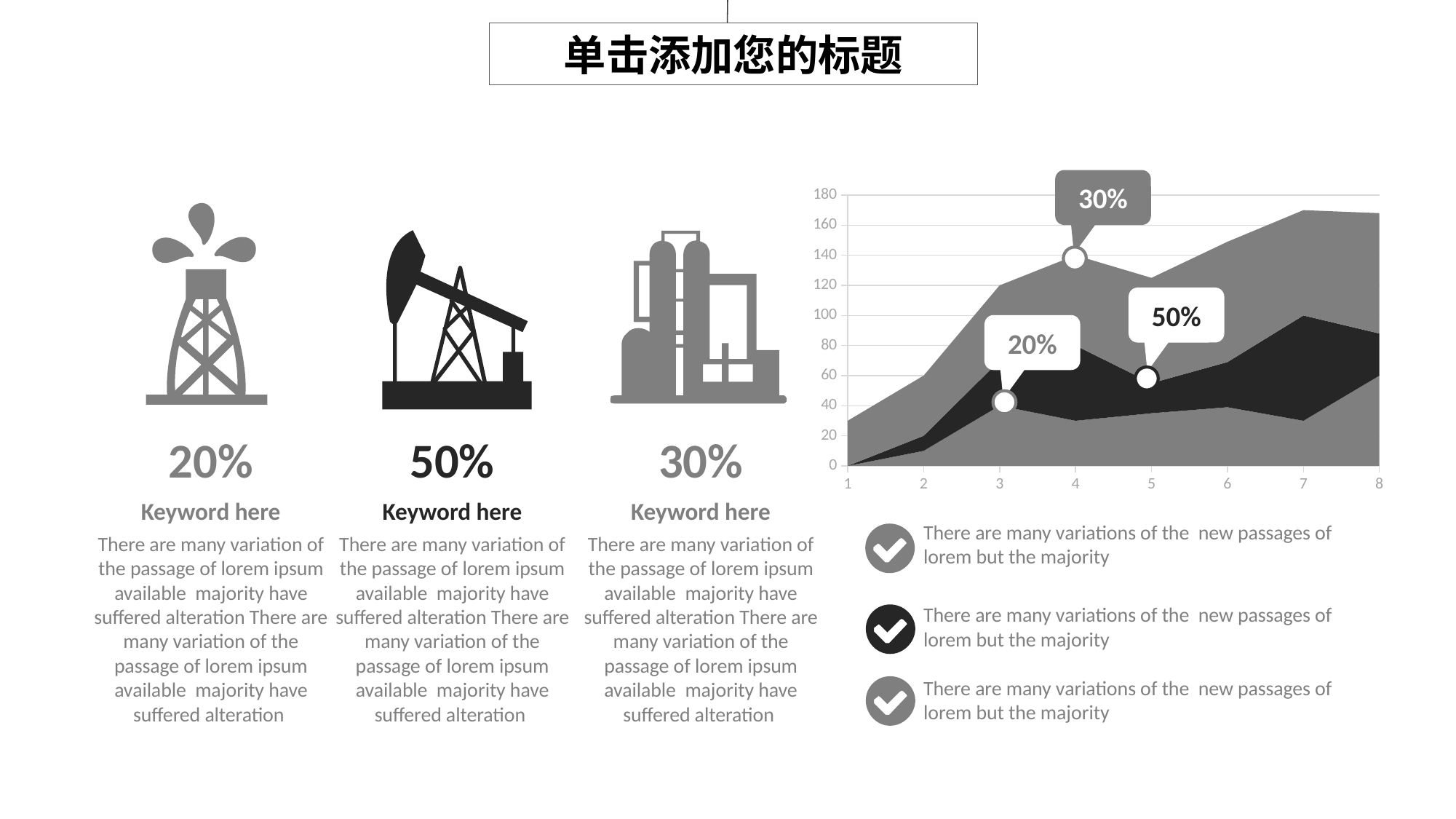
In the area chart, does the upper (gray) series generally rise or fall from x = 1 to x = 8? rise How many points are labelled along the x axis of the area chart? 8 In the area chart, is the value of the lower (black) series at x = 7 greater or less than 80? greater In the area chart, is the value of the upper (gray) series at x = 8 greater or less than 140? greater In the area chart, at which x value is the upper (gray) series lowest? 1 In the area chart, at which x value is the lower (black) series highest? 7 In the area chart, is the value of the lower (black) series at x = 1 greater or less than 20? less In the area chart, is the upper (gray) series larger at x = 7 or at x = 2? 7 What is the highest value shown on the y axis of the area chart? 180 What kind of chart is shown on the right of the slide? area chart